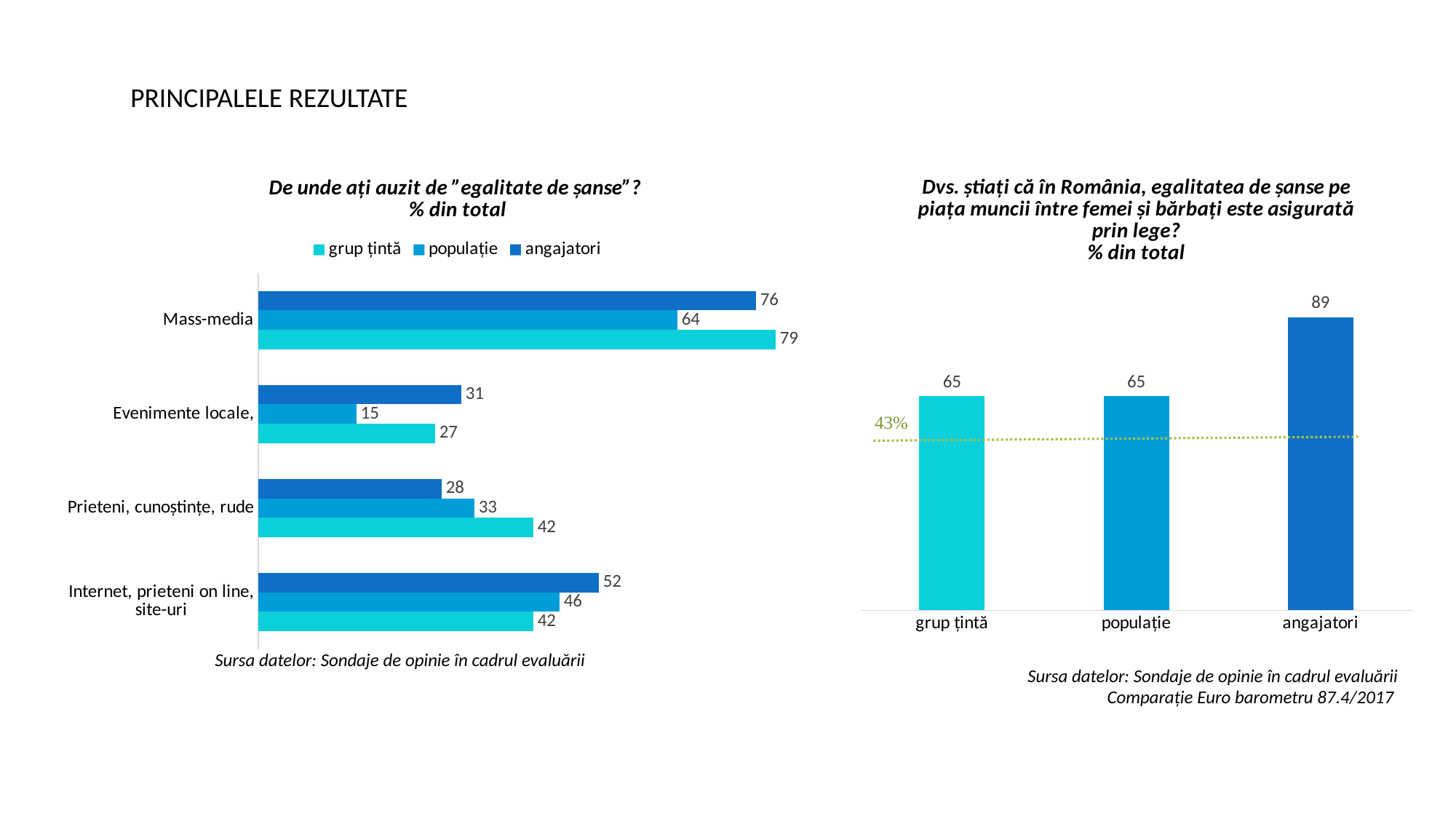
In the left chart, what is the value for angajatori in the Internet, prieteni on line, site-uri category? 52 How many categories are shown in the left chart? 4 In the left chart ("De unde ați auzit de "egalitate de șanse"?"), what is the value for populație in the Mass-media category? 64 How many series does the legend of the left chart list? 3 In the left chart, for Prieteni, cunoștințe, rude, which is larger: the value for grup țintă or for angajatori? grup țintă In the left chart, which category has the lowest value for populație? Evenimente locale In the right chart, what is the difference between the angajatori value and the grup țintă value? 24 In the left chart, which category has the highest value for grup țintă? Mass-media In the left chart, what is the difference between the grup țintă and populație values for Mass-media? 15 In the right chart, what percentage does the dotted reference line mark? 43% What kind of chart is the left chart? bar chart In the right chart ("Dvs. știați că în România..."), what is the value for angajatori? 89